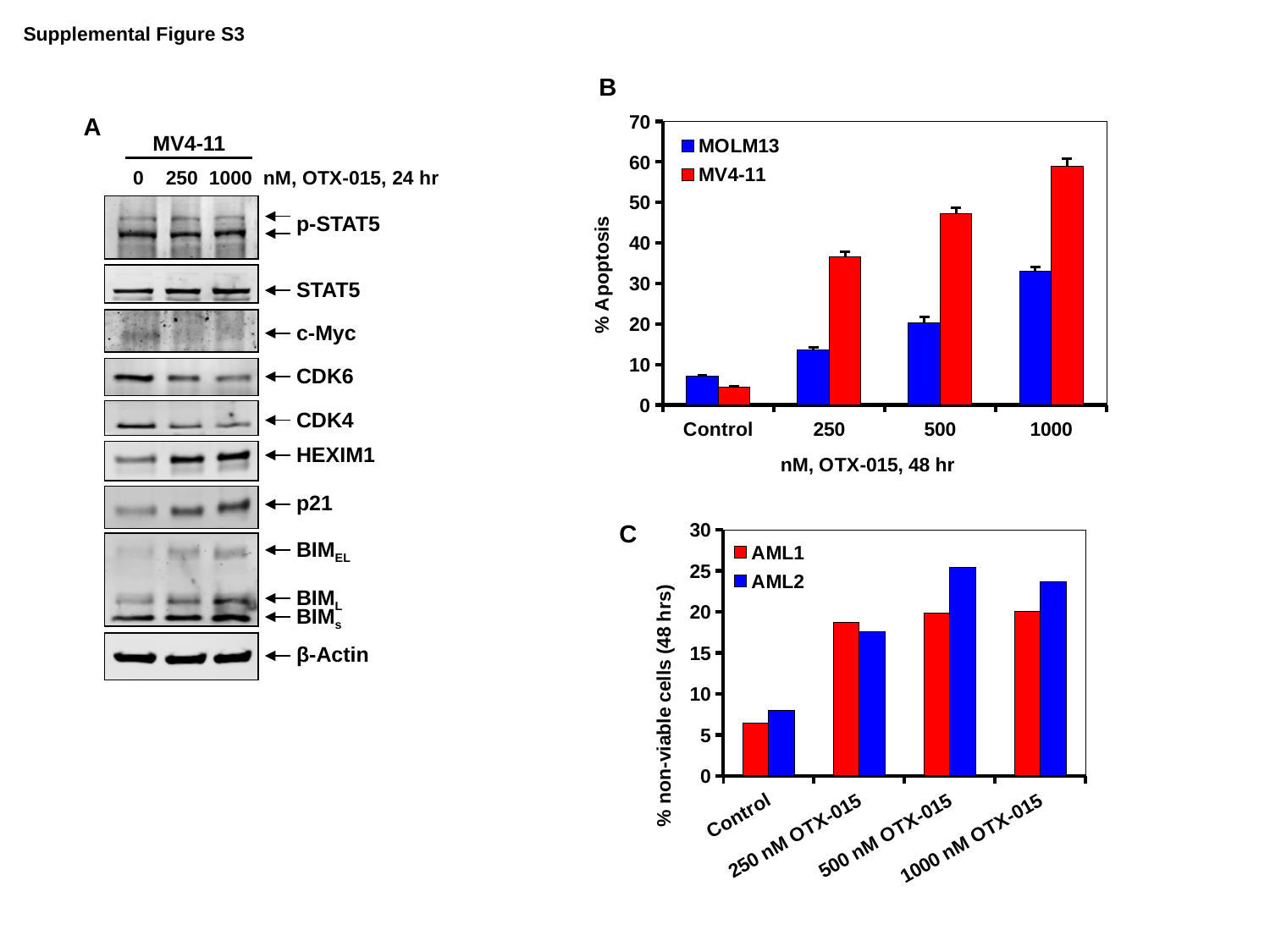
In chart B (% Apoptosis), how many concentration categories are shown on the x axis? 4 In chart C (% non-viable cells), which category has the highest value for AML2? 500 nM OTX-015 In chart B (% Apoptosis), is the value for MOLM13 at 500 nM greater or less than 30? less In chart C (% non-viable cells), which is larger at 1000 nM OTX-015, AML1 or AML2? AML2 In chart B (% Apoptosis), which is larger at 250 nM, MOLM13 or MV4-11? MV4-11 In chart B (% Apoptosis), does the MOLM13 series rise or fall from Control to 1000 nM? rise In chart C (% non-viable cells), what kind of chart is shown? bar chart In chart B (% Apoptosis), how many series does the legend list? 2 In chart C (% non-viable cells), what colour represents AML1? red In chart B (% Apoptosis), is the value for MV4-11 at 1000 nM greater or less than 50? greater In chart B (% Apoptosis), which concentration gives the highest % Apoptosis for MV4-11? 1000